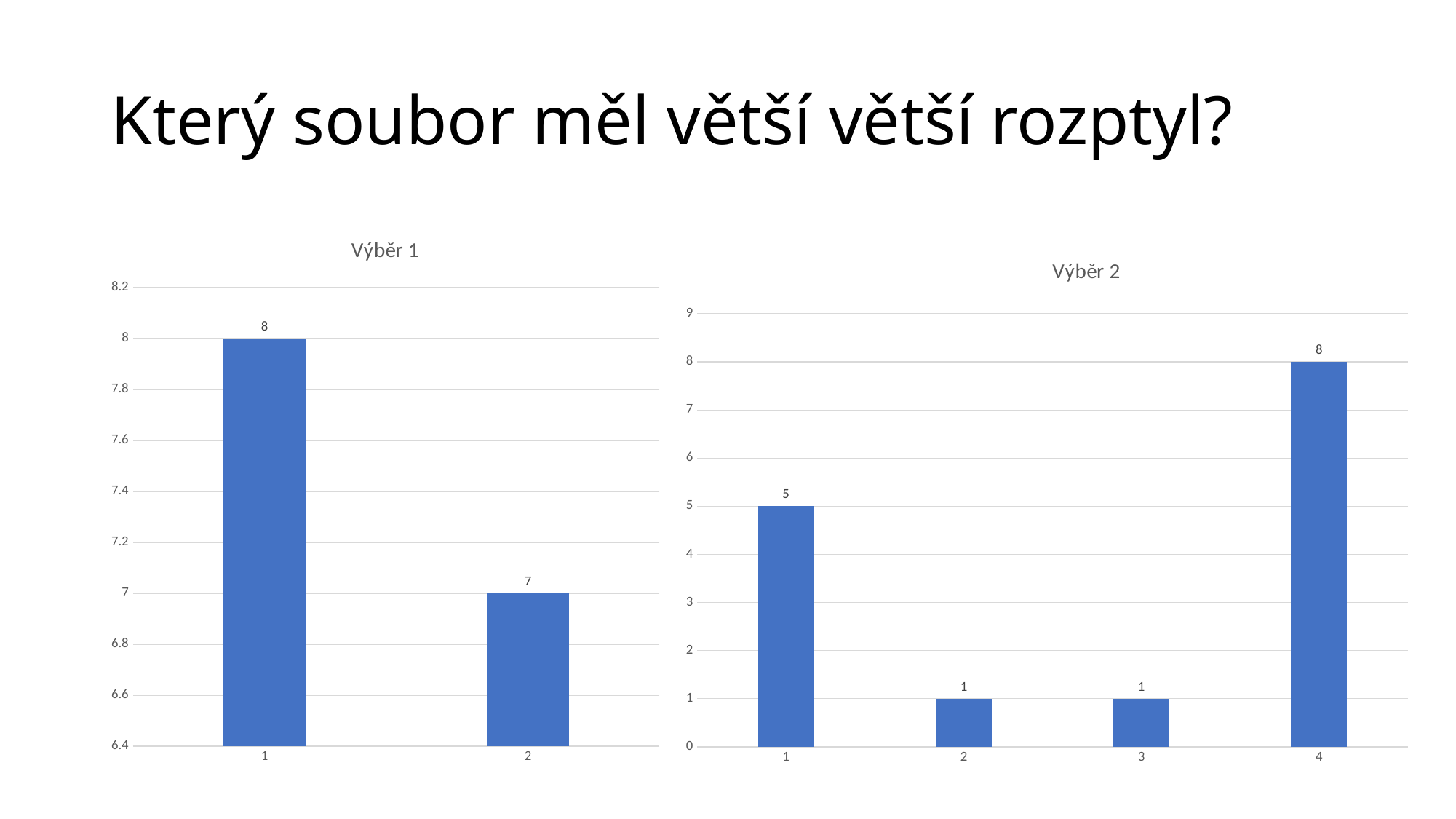
In the chart titled Výběr 1, what is the value for category 2? 7 In the chart titled Výběr 1, how many categories are plotted? 2 In the chart titled Výběr 2, what is the difference between the values for category 4 and category 1? 3 In the chart titled Výběr 2, is the value for category 1 larger than the value for category 2? Yes In the chart titled Výběr 2, which category has the highest value? 4 In the chart titled Výběr 1, what is the difference between the values for category 1 and category 2? 1 In the chart titled Výběr 2, what is the value for category 1? 5 What is the title of the chart on the left side of the slide? Výběr 1 What kind of chart is the chart titled Výběr 2? Bar chart In the chart titled Výběr 2, what is the value for category 4? 8 In the chart titled Výběr 1, what is the value for category 1? 8 In the chart titled Výběr 2, how many categories are plotted? 4